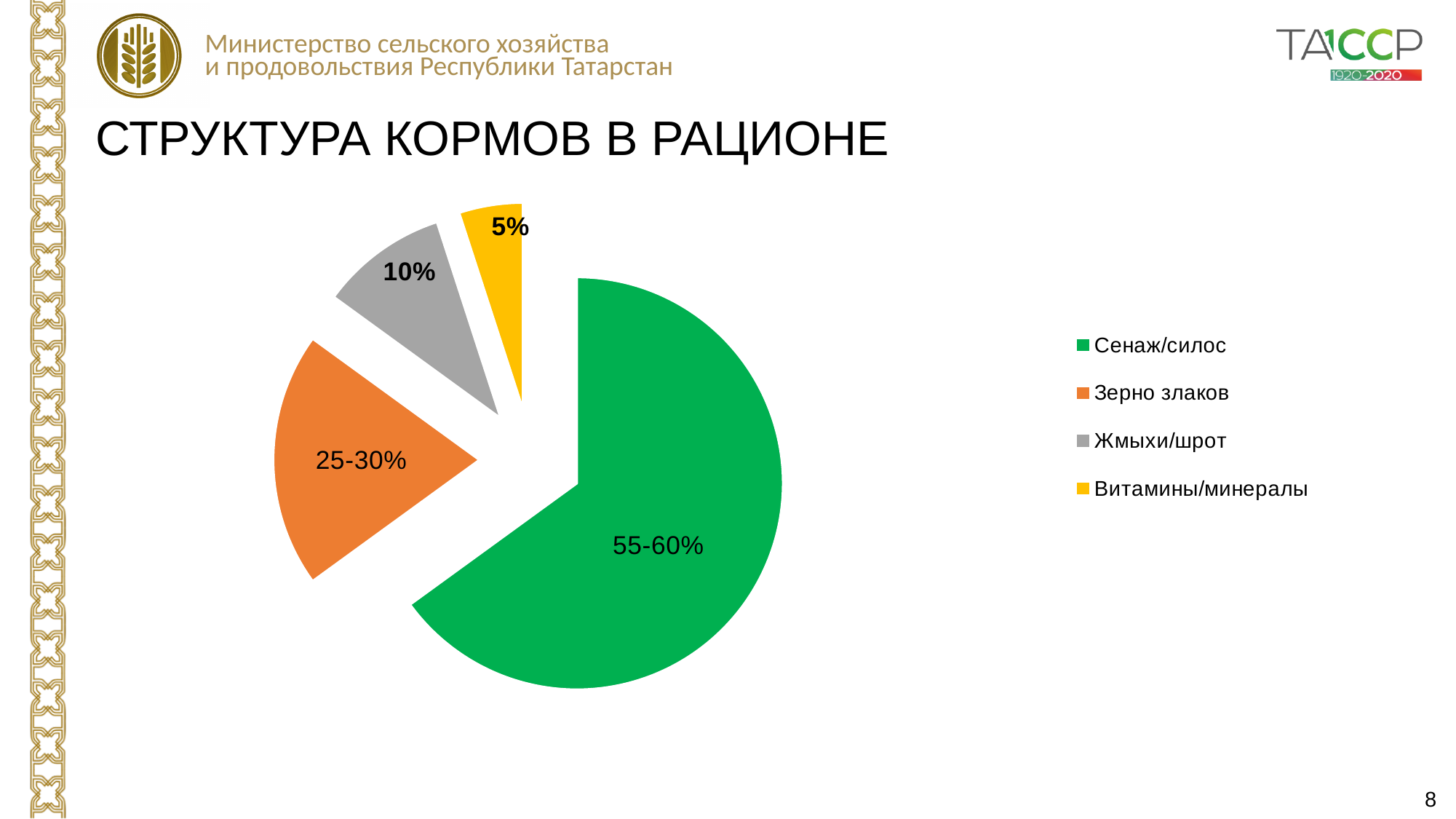
What colour is the Зерно злаков slice in the pie chart? Orange How many categories does the pie chart show? 4 Which is larger: the share for Жмыхи/шрот or the share for Витамины/минералы? Жмыхи/шрот What is the title of the slide containing the chart? СТРУКТУРА КОРМОВ В РАЦИОНЕ What percentage is labelled on the Жмыхи/шрот slice? 10% By how many percentage points does the Жмыхи/шрот share exceed the Витамины/минералы share? 5% Which category has the largest slice of the pie? Сенаж/силос What type of chart is shown on the slide? Pie chart What share of the ration does Сенаж/силос account for in the pie chart? 55-60% What percentage is labelled on the Витамины/минералы slice? 5% Which category has the smallest slice of the pie? Витамины/минералы What share is shown for Зерно злаков? 25-30%